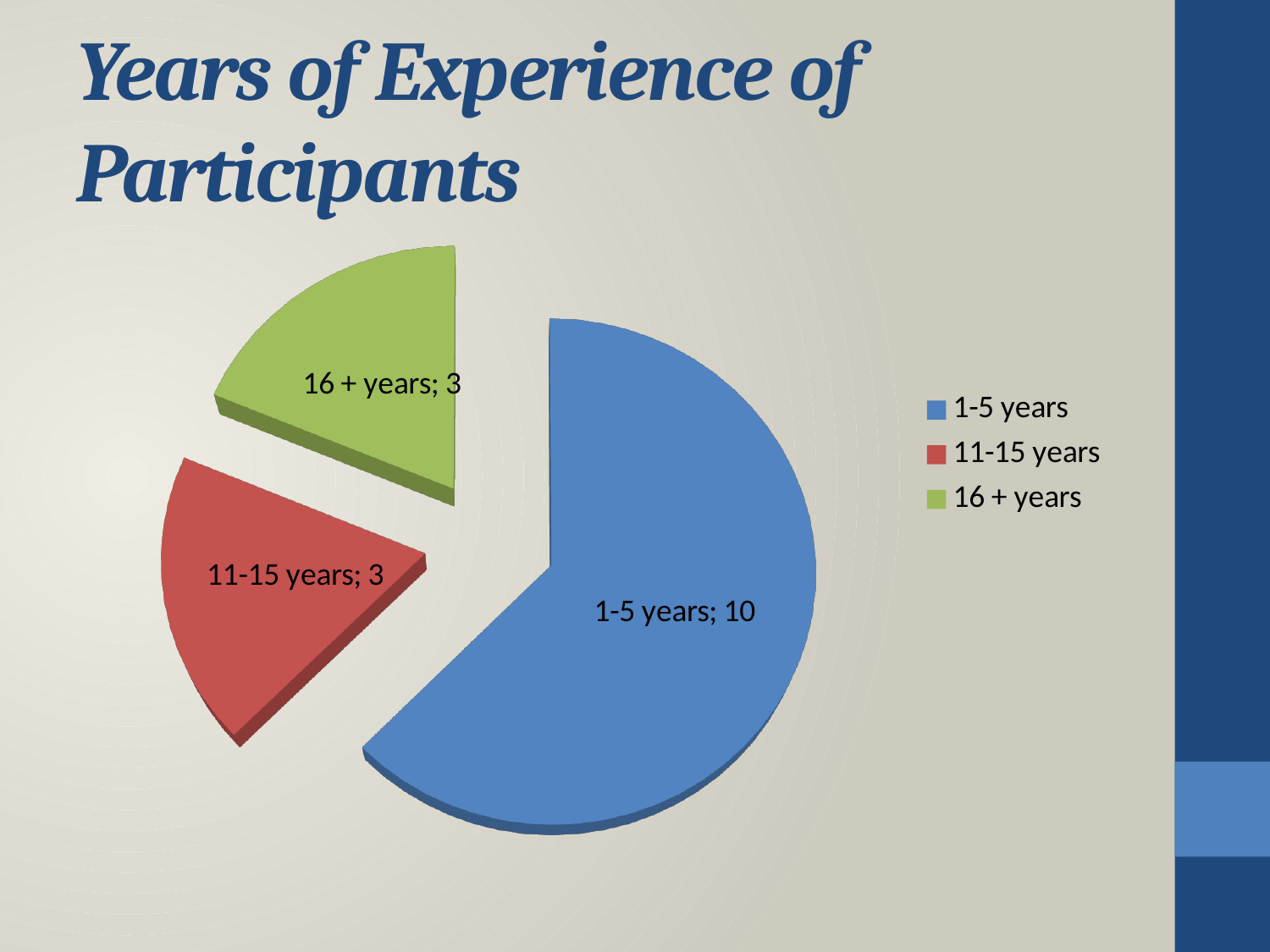
What is the value for the 1-5 years slice? 10 Do the 11-15 years and 16 + years slices have the same value? Yes What is the total of all the slices in the pie chart? 16 How many slices does the pie chart have? 3 What is the value for the 11-15 years slice? 3 What is the difference between the values for 1-5 years and 11-15 years? 7 What share of the pie does the 1-5 years slice represent? 62.5% What is the value for the 16 + years slice? 3 What type of chart is shown on the slide? Pie chart Which category has the largest slice of the pie? 1-5 years What is the title of the slide containing the chart? Years of Experience of Participants Which is larger, the value for 1-5 years or the value for 16 + years? 1-5 years